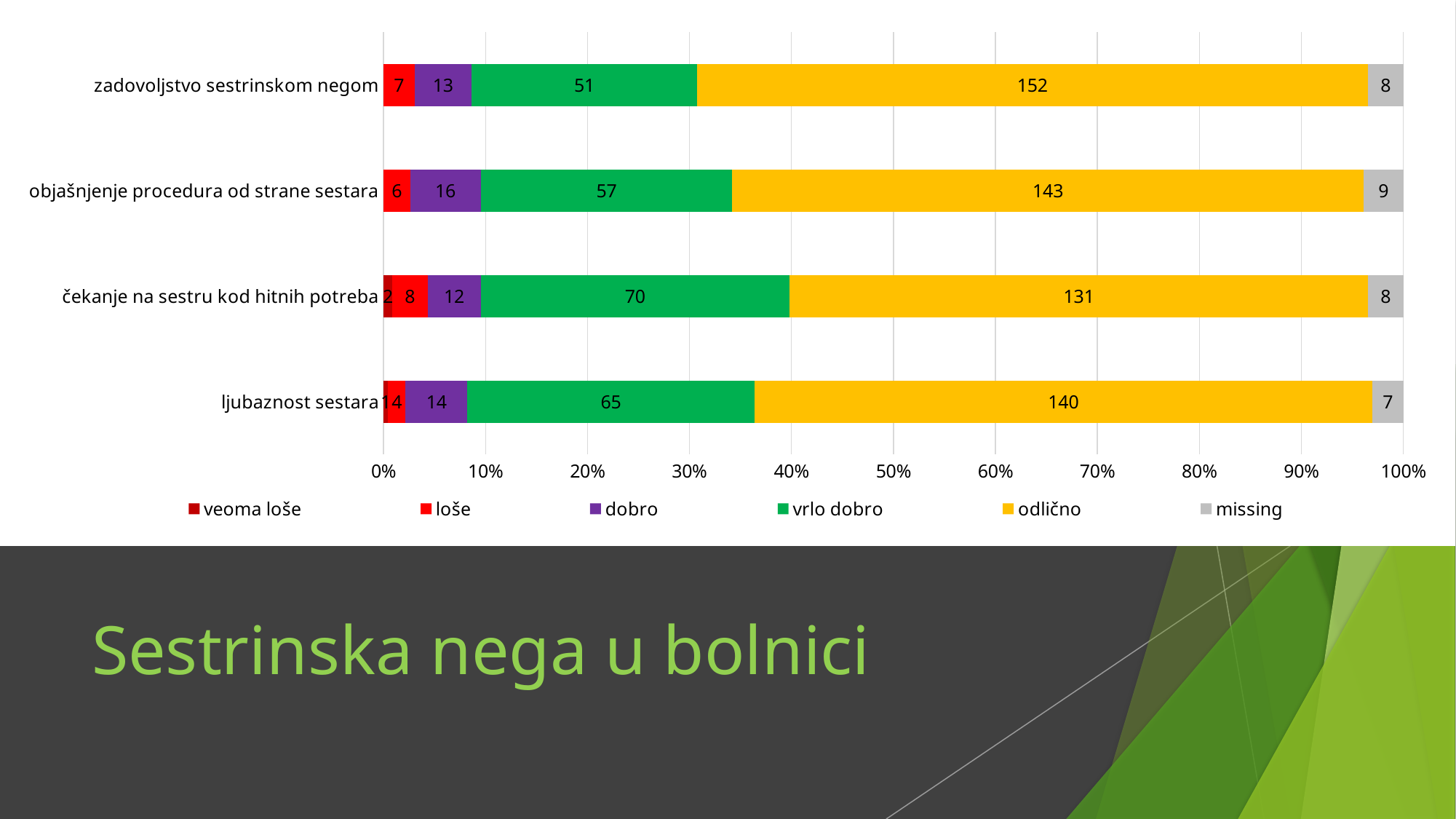
Which has the larger 'vrlo dobro' value: 'čekanje na sestru kod hitnih potreba' or 'ljubaznost sestara'? čekanje na sestru kod hitnih potreba What is the difference between the 'odlično' values for 'zadovoljstvo sestrinskom negom' and 'objašnjenje procedura od strane sestara'? 9 Which category has the highest 'odlično' value? zadovoljstvo sestrinskom negom What is the 'missing' value for 'objašnjenje procedura od strane sestara'? 9 How many series does the legend list? 6 What kind of chart is shown on the slide? bar chart How many categories are plotted on the chart? 4 What is the title text shown below the chart on the slide? Sestrinska nega u bolnici What is the 'odlično' value for 'zadovoljstvo sestrinskom negom'? 152 Which category has the lowest 'odlično' value? čekanje na sestru kod hitnih potreba What is the 'vrlo dobro' value for 'čekanje na sestru kod hitnih potreba'? 70 What is the total of all segments in the 'čekanje na sestru kod hitnih potreba' bar? 231